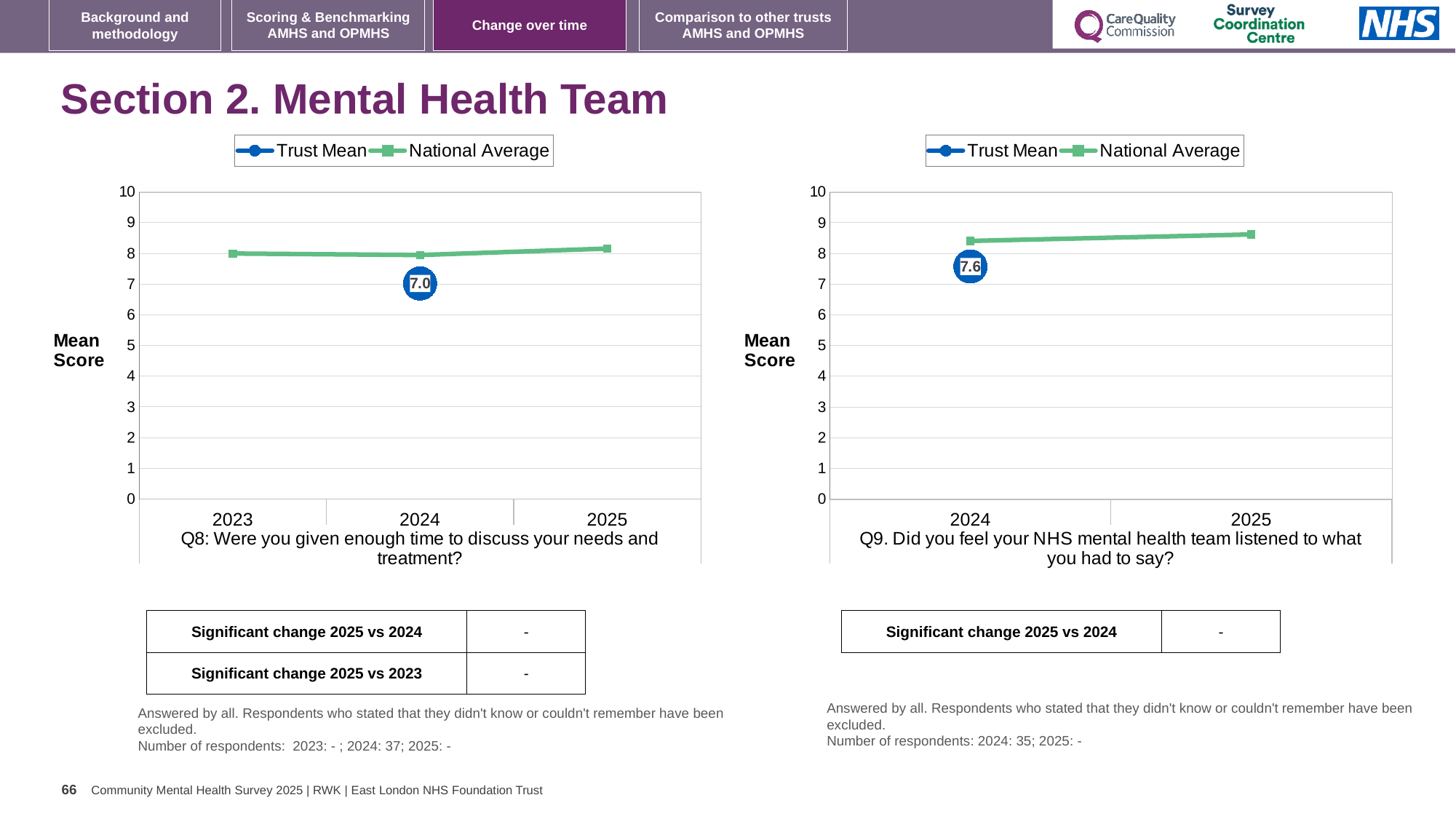
What is the label on the y axis of the left chart (Q8)? Mean Score How many years are shown on the x axis of the left chart (Q8)? 3 In the right chart (Q9), what is the Trust Mean value labelled for 2024? 7.6 How many years are shown on the x axis of the right chart (Q9)? 2 How many series does the legend of the right chart (Q9) list? 2 What kind of chart is the left chart (Q8)? Line chart In the right chart (Q9), does the National Average rise or fall from 2024 to 2025? Rise In the left chart (Q8), is the National Average value for 2025 greater or less than 7? greater In the right chart (Q9), which is larger for 2024: the Trust Mean or the National Average? National Average In the left chart (Q8), what is the Trust Mean value labelled for 2024? 7.0 In the left chart (Q8), which is larger for 2024: the Trust Mean or the National Average? National Average In the right chart (Q9), is the National Average value for 2024 greater or less than 9? less